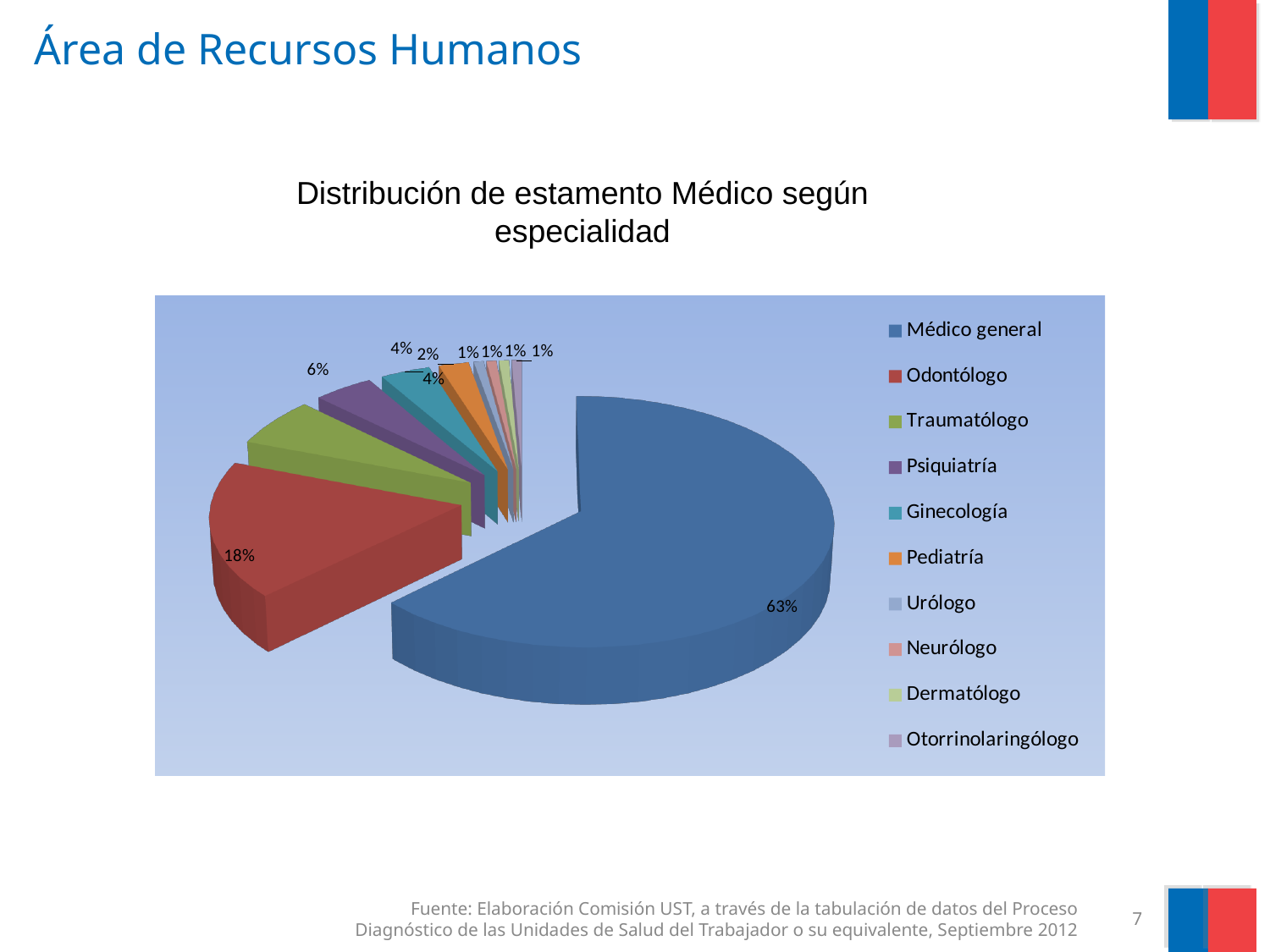
Which is larger, the slice for Odontólogo or the slice for Traumatólogo? Odontólogo Which specialty has the largest slice of the pie? Médico general What is the title of the chart? Distribución de estamento Médico según especialidad What is the value shown for Pediatría? 2% Which legend entry is shown in red? Odontólogo What is the value shown for Odontólogo? 18% How many specialties are listed in the legend? 10 What is the combined share of Médico general and Odontólogo? 81% What kind of chart is shown on the slide? pie chart What is the value shown for Traumatólogo? 6% What share of the pie does Médico general represent? 63% What is the difference in percentage points between Médico general and Odontólogo? 45